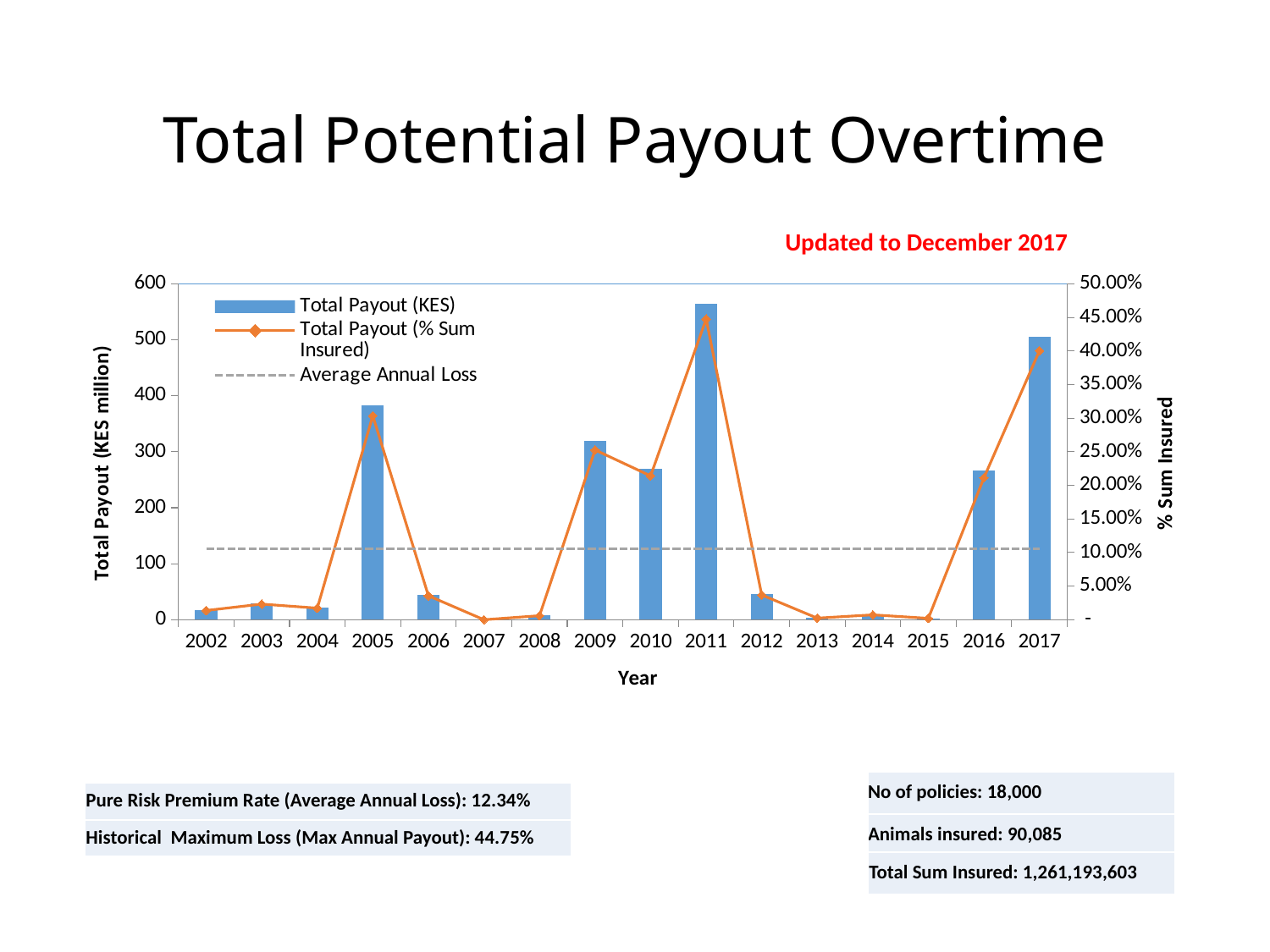
Which year has the highest Total Payout (KES) bar? 2011 Do the Total Payout (KES) bars rise or fall from 2014 to 2017? rise Is the Total Payout (KES) bar for 2016 greater or less than 200? greater Is the Total Payout (KES) bar for 2011 greater or less than 500? greater How many years are shown along the x axis of the chart? 16 What kind of chart is shown on the slide? A combined bar and line chart How many series does the chart legend list? 3 Which year has the larger Total Payout (KES) bar, 2016 or 2017? 2017 What is the title of the chart on the slide? Total Potential Payout Overtime Is the Total Payout (KES) bar for 2012 greater or less than 100? less Which year has the larger Total Payout (KES) bar, 2005 or 2009? 2005